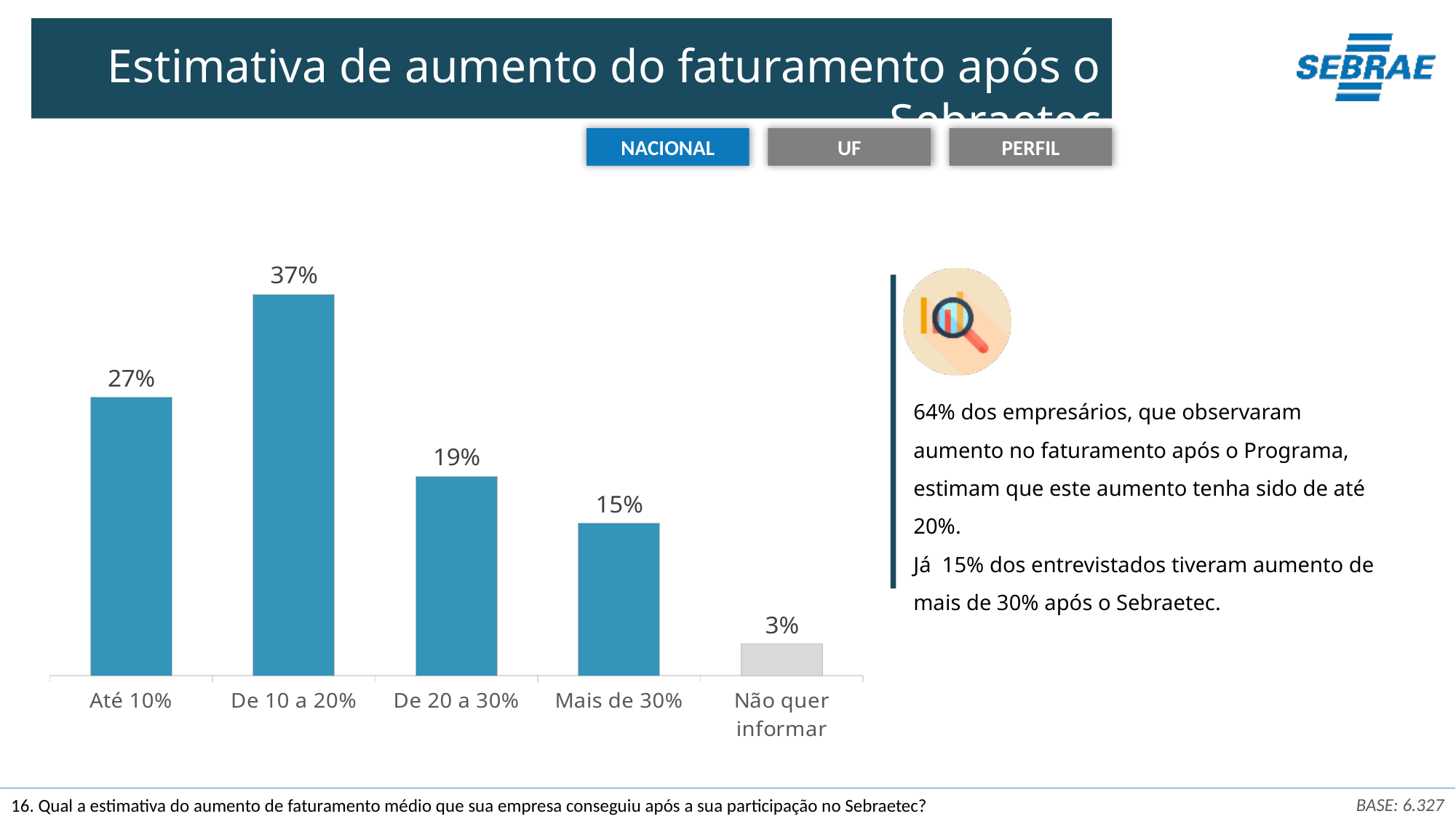
Which bar is shown in a different colour (grey) from the others? Não quer informar Which category has the lowest value? Não quer informar What kind of chart is shown on the slide? Bar chart Which category has the highest value? De 10 a 20% What is the value for 'De 20 a 30%'? 19% What is the value for 'De 10 a 20%'? 37% How many categories are shown in the chart? 5 What is the value for 'Até 10%'? 27% What is the value for 'Mais de 30%'? 15% What is the difference between the values for 'De 10 a 20%' and 'Até 10%'? 10% Which is larger, the value for 'De 20 a 30%' or the value for 'Mais de 30%'? De 20 a 30% What is the value for 'Não quer informar'? 3%